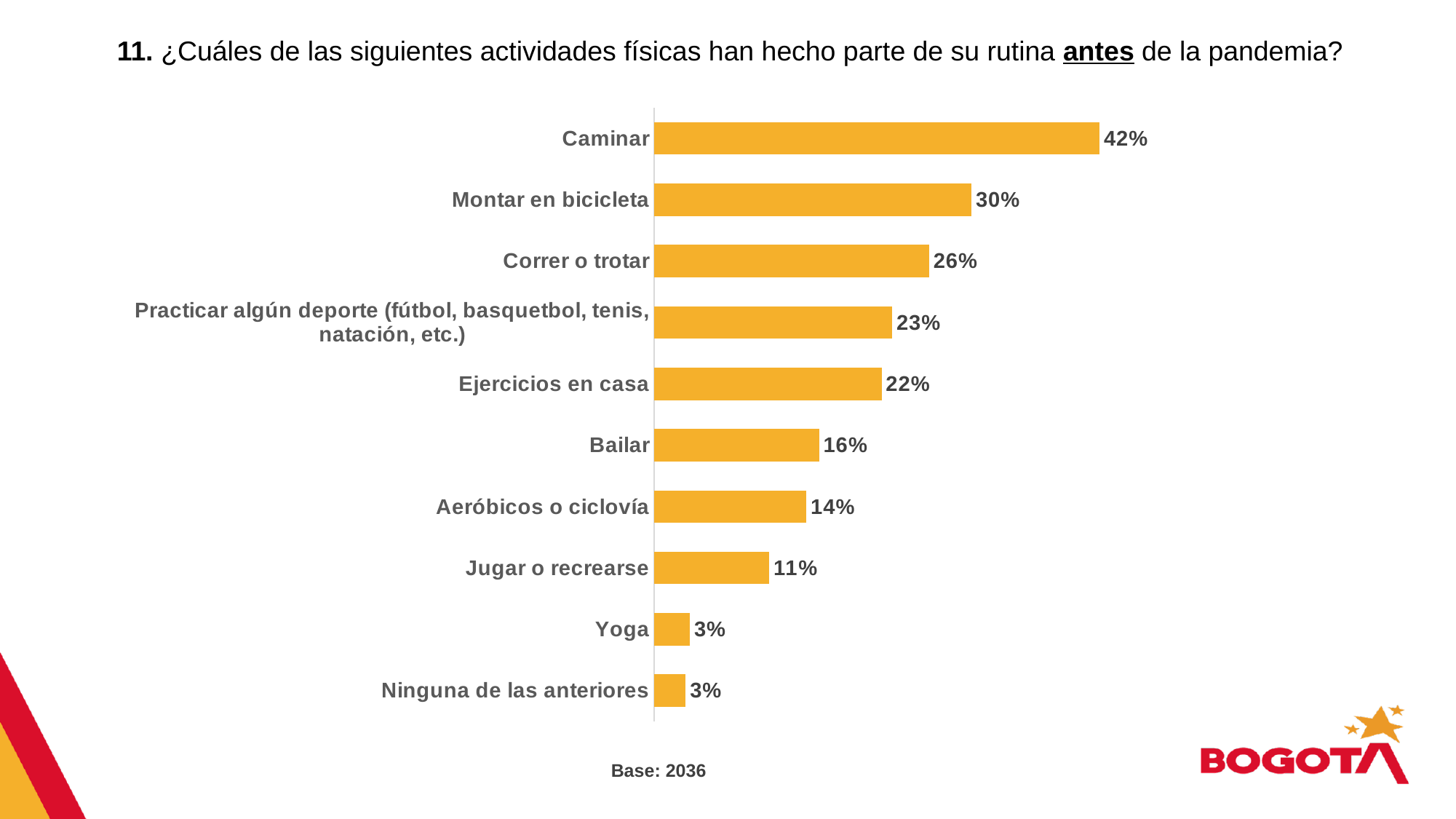
What is the value shown for 'Aeróbicos o ciclovía'? 14% What percentage of respondents reported 'Caminar' as part of their routine before the pandemic? 42% What is the difference between the values for 'Correr o trotar' and 'Bailar'? 10% How many categories are shown on the chart? 10 Which has a larger value, 'Montar en bicicleta' or 'Correr o trotar'? Montar en bicicleta Which has a larger value, 'Jugar o recrearse' or 'Bailar'? Bailar What is the base (number of respondents) shown below the chart? 2036 What kind of chart is shown on the slide? Bar chart Which activity has the highest percentage on the chart? Caminar What is the value shown for 'Ejercicios en casa'? 22% What colour are the bars in the chart? Orange What is the difference between the values for 'Caminar' and 'Montar en bicicleta'? 12%